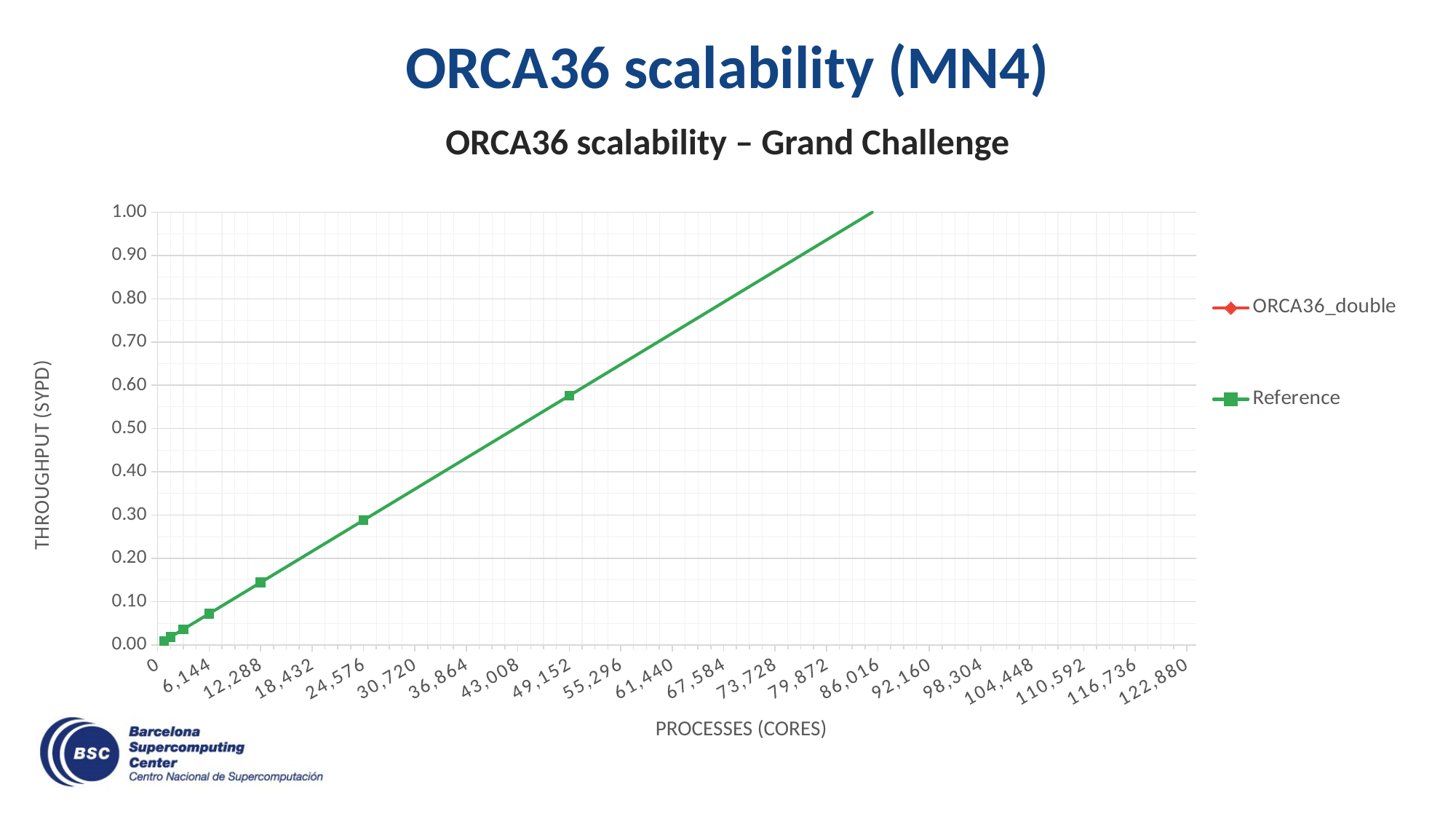
Is the Reference throughput at 24,576 processes greater or less than 0.20 SYPD? greater Is the Reference throughput at 49,152 processes greater or less than 0.70 SYPD? less Is the Reference throughput at 49,152 processes greater or less than 0.50 SYPD? greater What kind of chart is shown on the slide? line chart How many series does the legend list? 2 Which series is drawn in green in the legend? Reference Does the Reference series rise or fall as the number of processes (cores) increases? rise What is the title of the chart? ORCA36 scalability – Grand Challenge